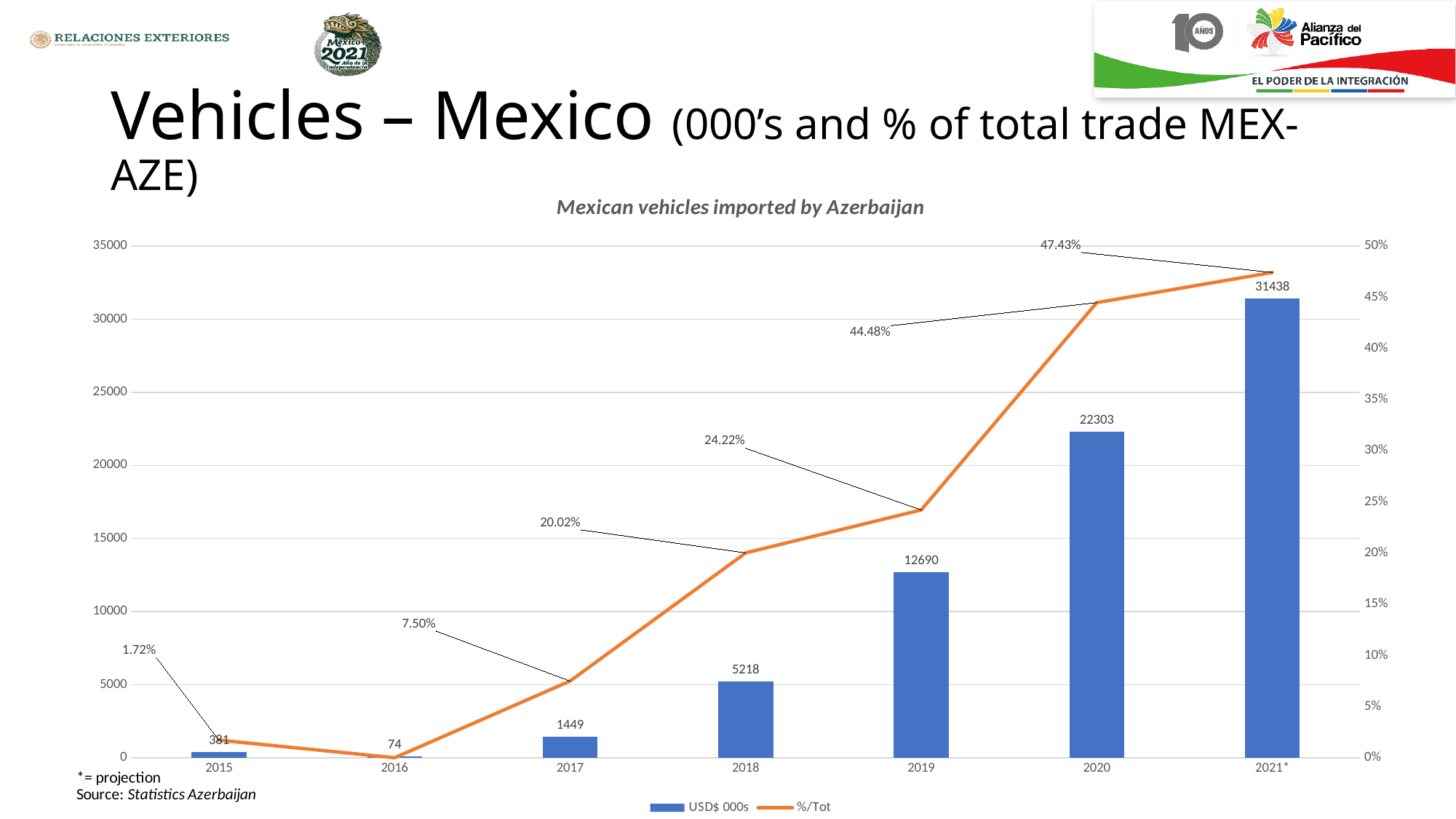
Is the USD$ 000s value for 2020 greater or less than 20000? greater Which is larger, the USD$ 000s value for 2017 or for 2018? 2018 Which year has the highest %/Tot value? 2021* Do the USD$ 000s values rise or fall from 2016 to 2021*? rise What is the USD$ 000s value for 2021*? 31438 What is the difference in USD$ 000s between 2020 and 2019? 9613 What is the USD$ 000s value for 2019? 12690 What is the %/Tot value for 2020? 44.48% How many series does the legend list? 2 How many years are shown on the x axis? 7 Which year has the lowest USD$ 000s value? 2016 What is the title of the chart? Mexican vehicles imported by Azerbaijan